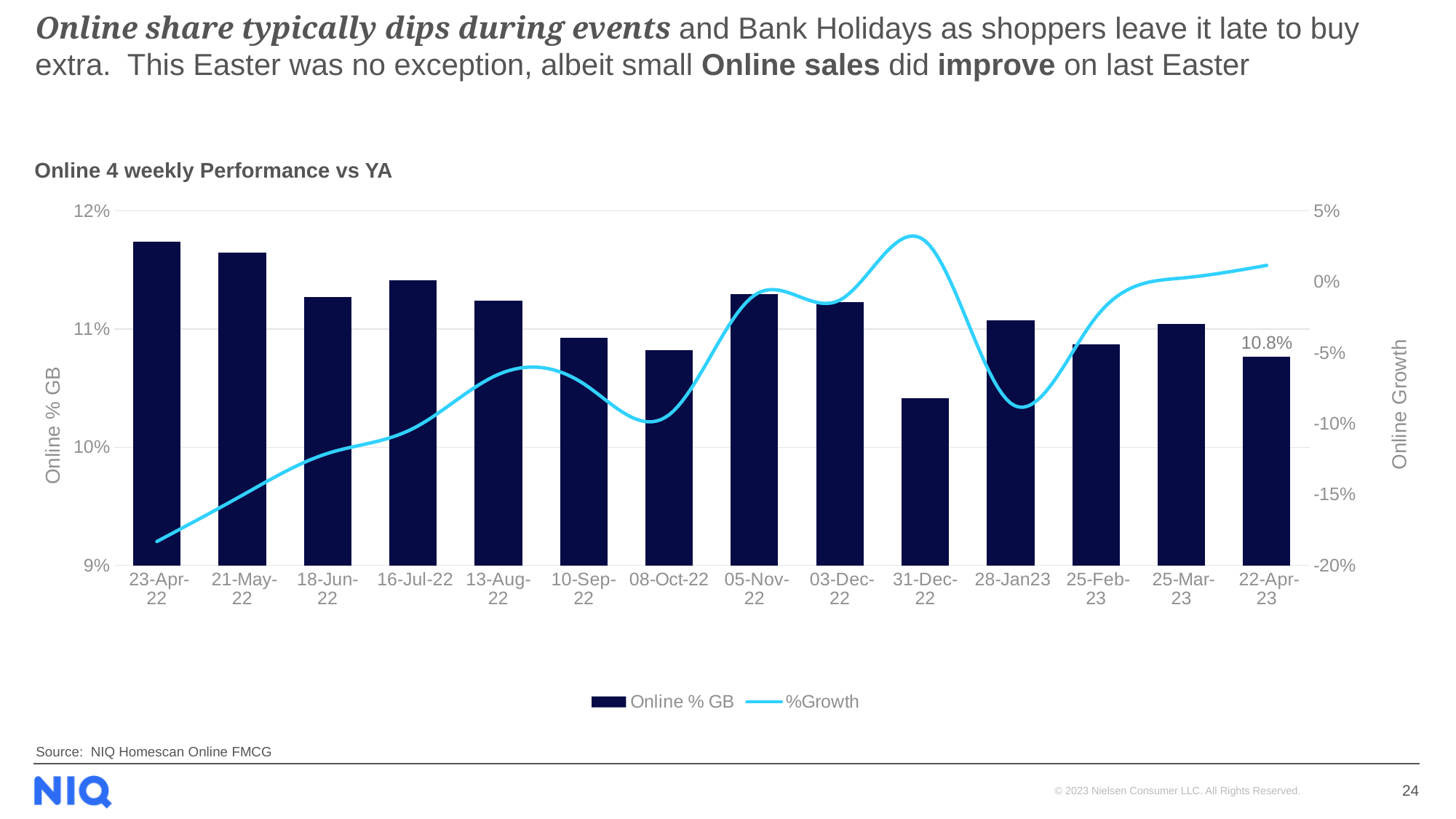
Which period has the highest Online % GB bar? 23-Apr-22 Which period has the lowest Online % GB bar? 31-Dec-22 Is the Online % GB value for 16-Jul-22 greater or less than 11%? greater Is the %Growth value for 31-Dec-22 greater or less than 0%? greater Which has the larger Online % GB value, 05-Nov-22 or 31-Dec-22? 05-Nov-22 Does the %Growth line rise or fall from 23-Apr-22 to 16-Jul-22? rise What is the Online % GB value for 22-Apr-23? 10.8% How many series does the legend list? 2 Is the Online % GB value for 31-Dec-22 greater or less than 11%? less How many periods are shown on the x axis? 14 What kind of chart is shown? Bar and line chart